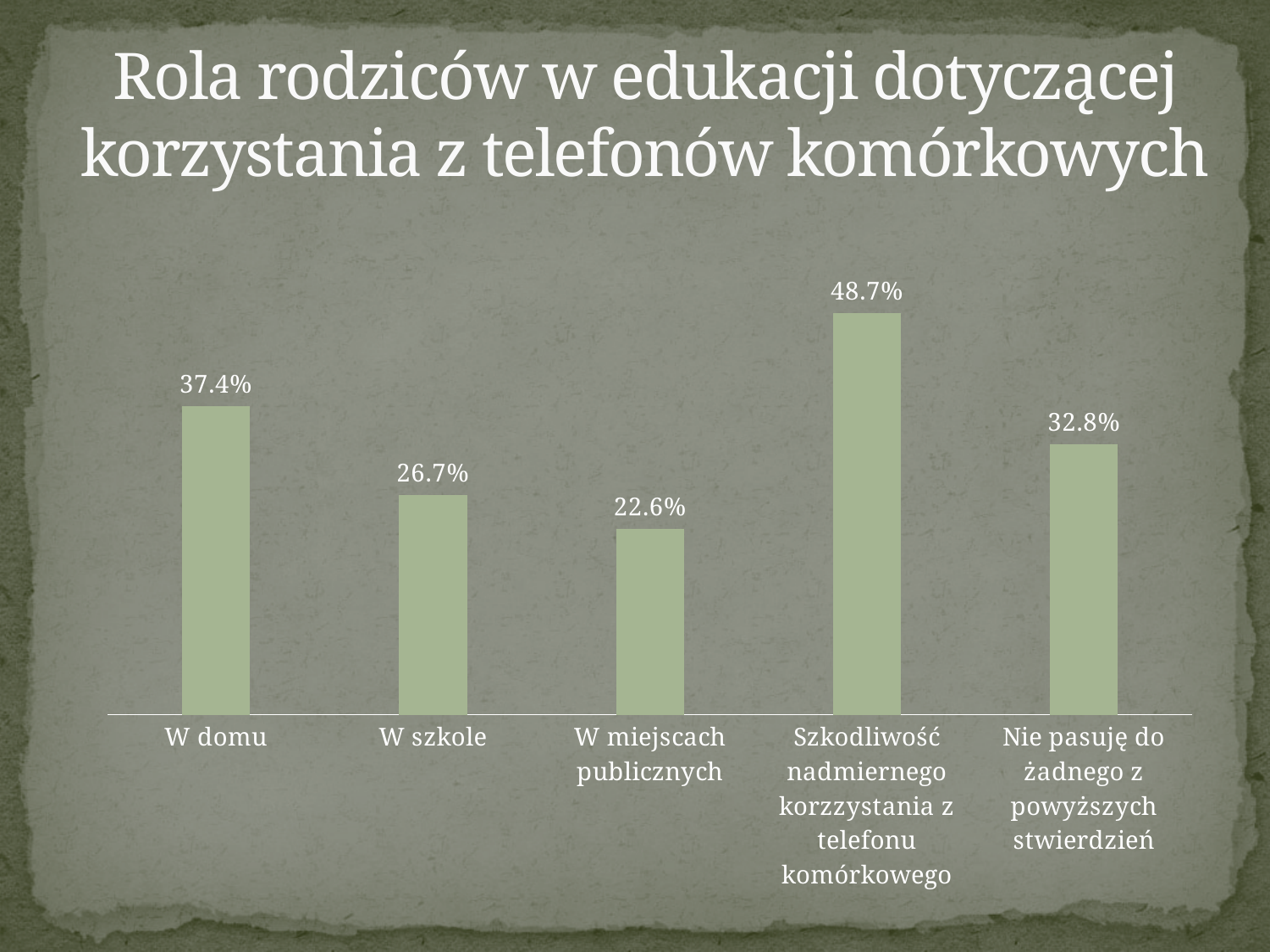
What is the difference between the values for "W domu" and "W szkole"? 10.7% Which category has the highest value? Szkodliwość nadmiernego korzzystania z telefonu komórkowego What is the value for "W szkole"? 26.7% What is the value for "W miejscach publicznych"? 22.6% What is the value for "Nie pasuję do żadnego z powyższych stwierdzień"? 32.8% What kind of chart is shown on the slide? Bar chart What is the title of the slide? Rola rodziców w edukacji dotyczącej korzystania z telefonów komórkowych How many categories are shown in the chart? 5 Which category has the lowest value? W miejscach publicznych Which is larger, the value for "W domu" or the value for "Nie pasuję do żadnego z powyższych stwierdzień"? W domu What is the value for "Szkodliwość nadmiernego korzzystania z telefonu komórkowego"? 48.7% What is the value for "W domu"? 37.4%